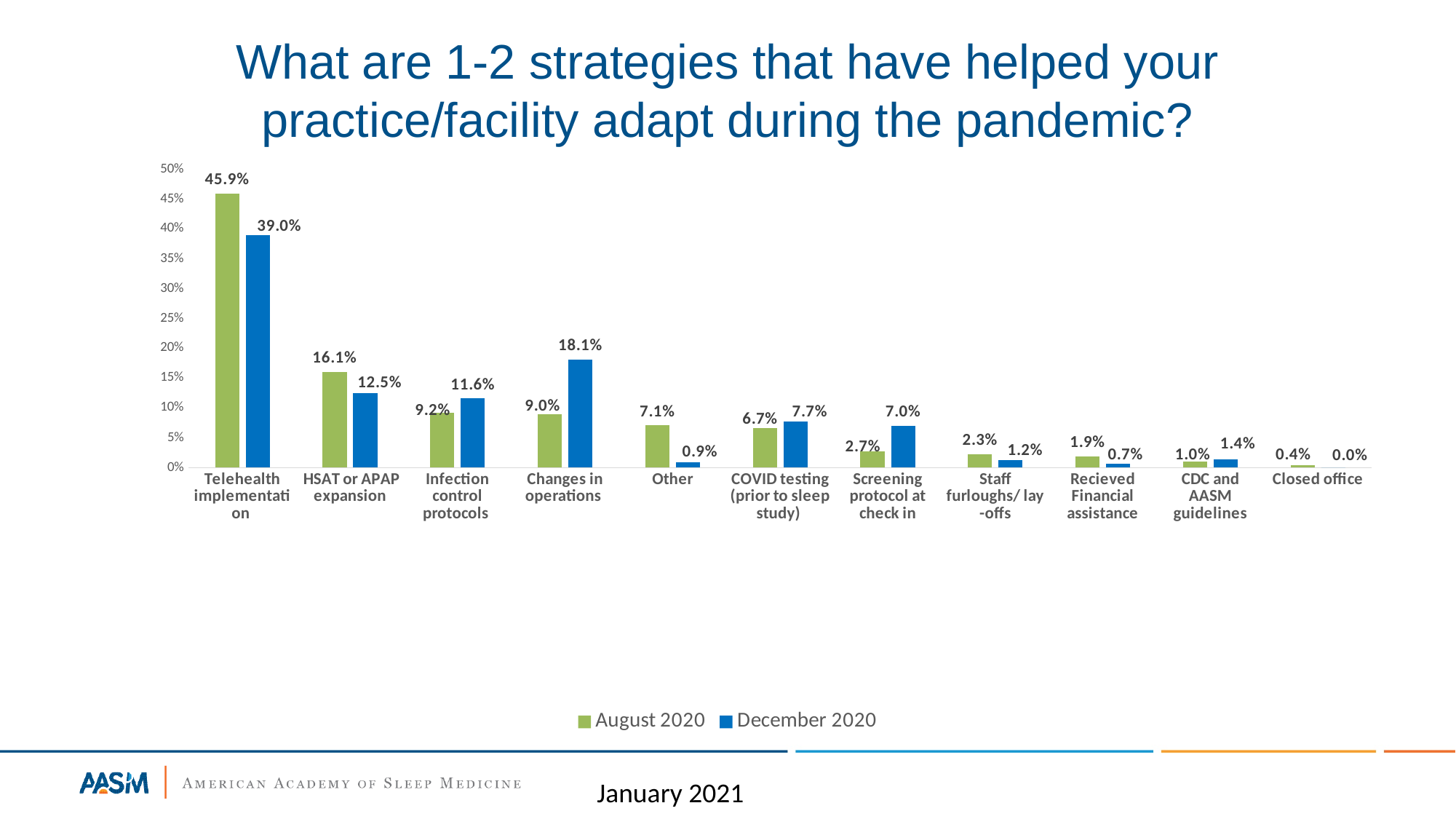
What is the December 2020 value for Changes in operations? 18.1% Which is larger for HSAT or APAP expansion: the August 2020 value or the December 2020 value? August 2020 What is the December 2020 value for Other? 0.9% What is the difference between the August 2020 and December 2020 values for Telehealth implementation? 6.9% What is the difference between the December 2020 and August 2020 values for Changes in operations? 9.1% What kind of chart is shown on the slide? Bar chart How many categories are shown on the x axis? 11 Which category has the lowest August 2020 value? Closed office How many series does the legend list? 2 What is the August 2020 value for Telehealth implementation? 45.9% Which category has the highest December 2020 value? Telehealth implementation Is the December 2020 value for Telehealth implementation greater or less than 35%? greater